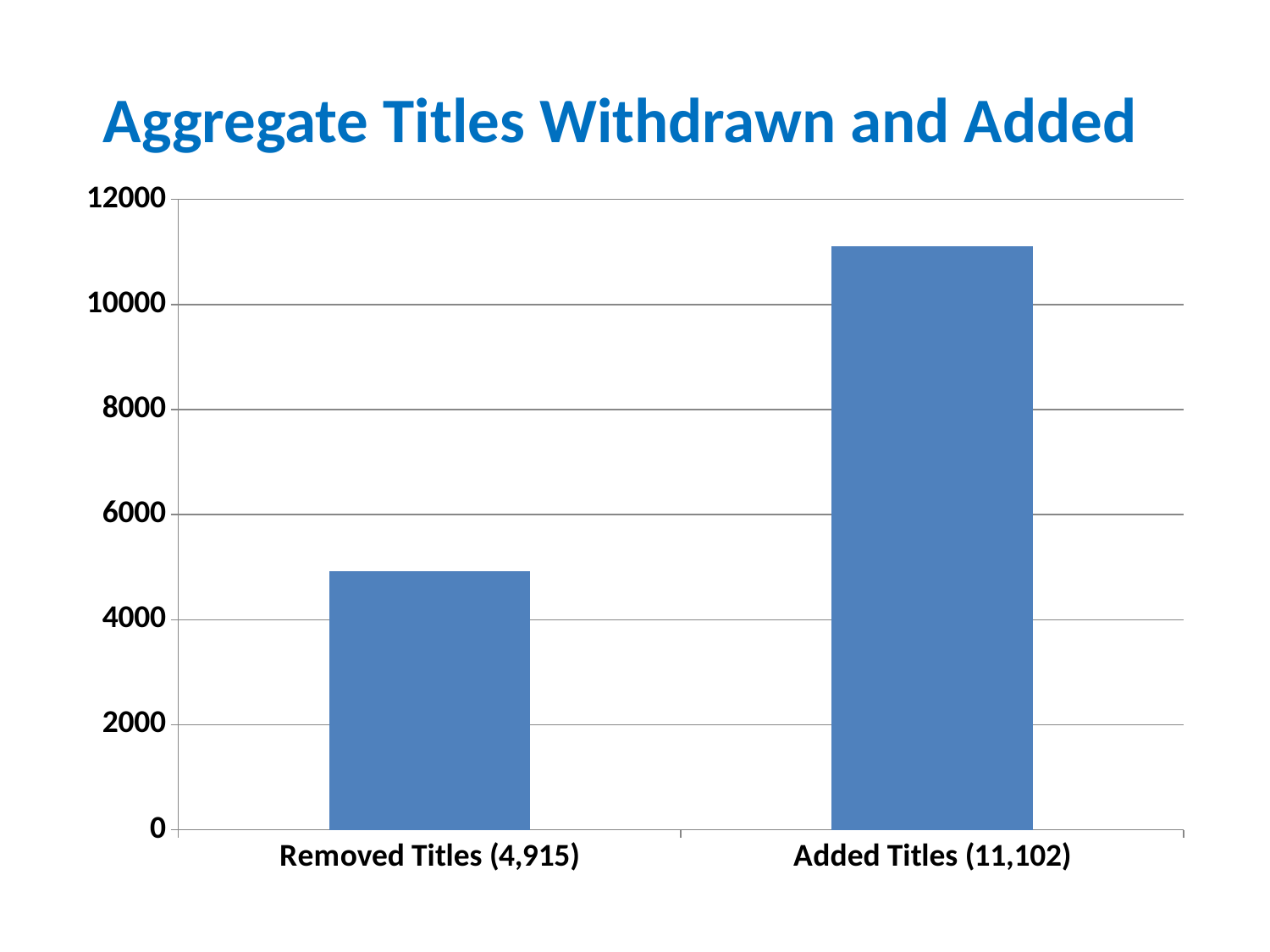
What kind of chart is shown on the slide? bar chart What is the difference between Added Titles and Removed Titles? 6,187 What is the value for Added Titles? 11,102 What is the value for Removed Titles? 4,915 What is the title of the slide? Aggregate Titles Withdrawn and Added Is the value for Removed Titles greater or less than 6000? less What is the highest value shown on the vertical axis? 12000 Which category has the lowest value? Removed Titles Is the value for Added Titles greater or less than 10000? greater Which category has the highest value? Added Titles How many categories are shown in the chart? 2 Which is larger, Removed Titles or Added Titles? Added Titles